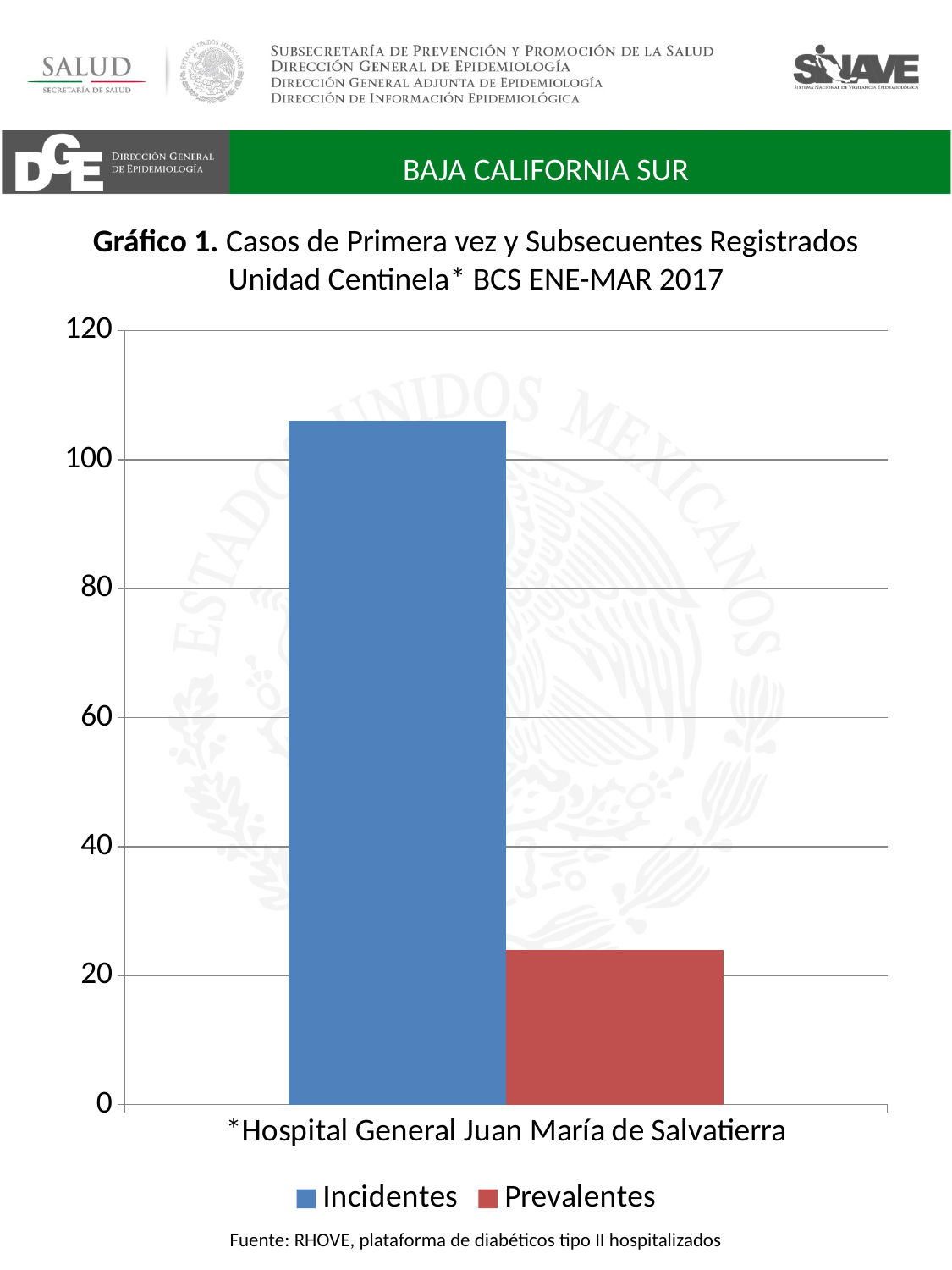
Which series has the taller bar, Incidentes or Prevalentes? Incidentes Is the value for Incidentes greater or less than 120? less What colour is the bar for Prevalentes? red Is the value for Prevalentes greater or less than 40? less Which series has the lowest value? Prevalentes How many series does the legend list? 2 What is the category label shown on the x axis? *Hospital General Juan María de Salvatierra Which series has the highest value? Incidentes Is the value for Prevalentes greater or less than 20? greater What kind of chart is shown on the slide? bar chart How many categories are shown on the x axis? 1